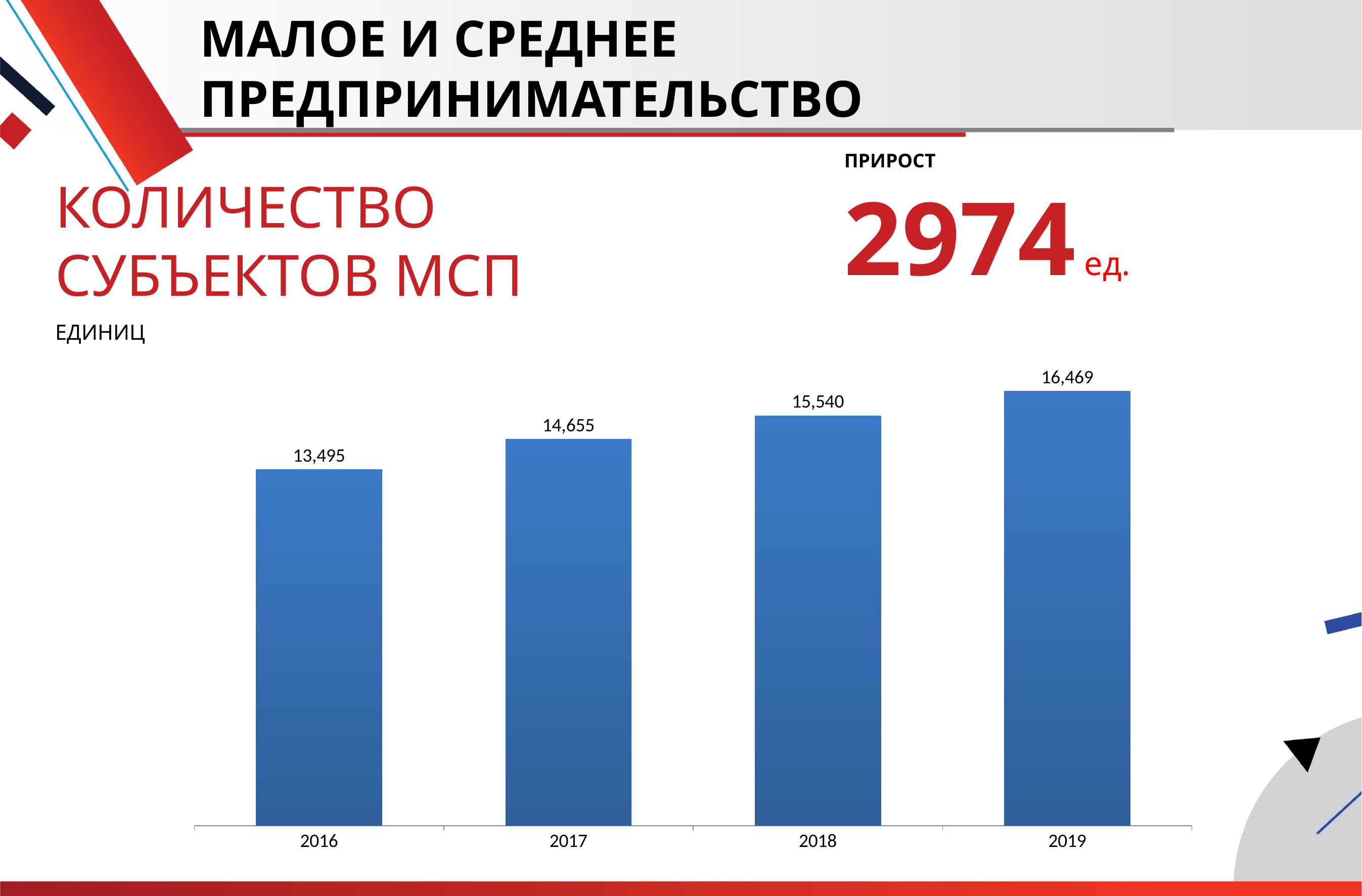
What is the value for 2017? 14,655 What is the value for 2016? 13,495 What is the value for 2019? 16,469 Do the values rise or fall from 2016 to 2019? rise What is the difference between the values for 2019 and 2016? 2,974 Which is larger, the value for 2017 or the value for 2018? 2018 What kind of chart is shown on the slide? bar chart Which year has the lowest value? 2016 Which year has the highest value? 2019 How many years are shown on the x axis? 4 What is the value for 2018? 15,540 What is the difference between the values for 2018 and 2017? 885